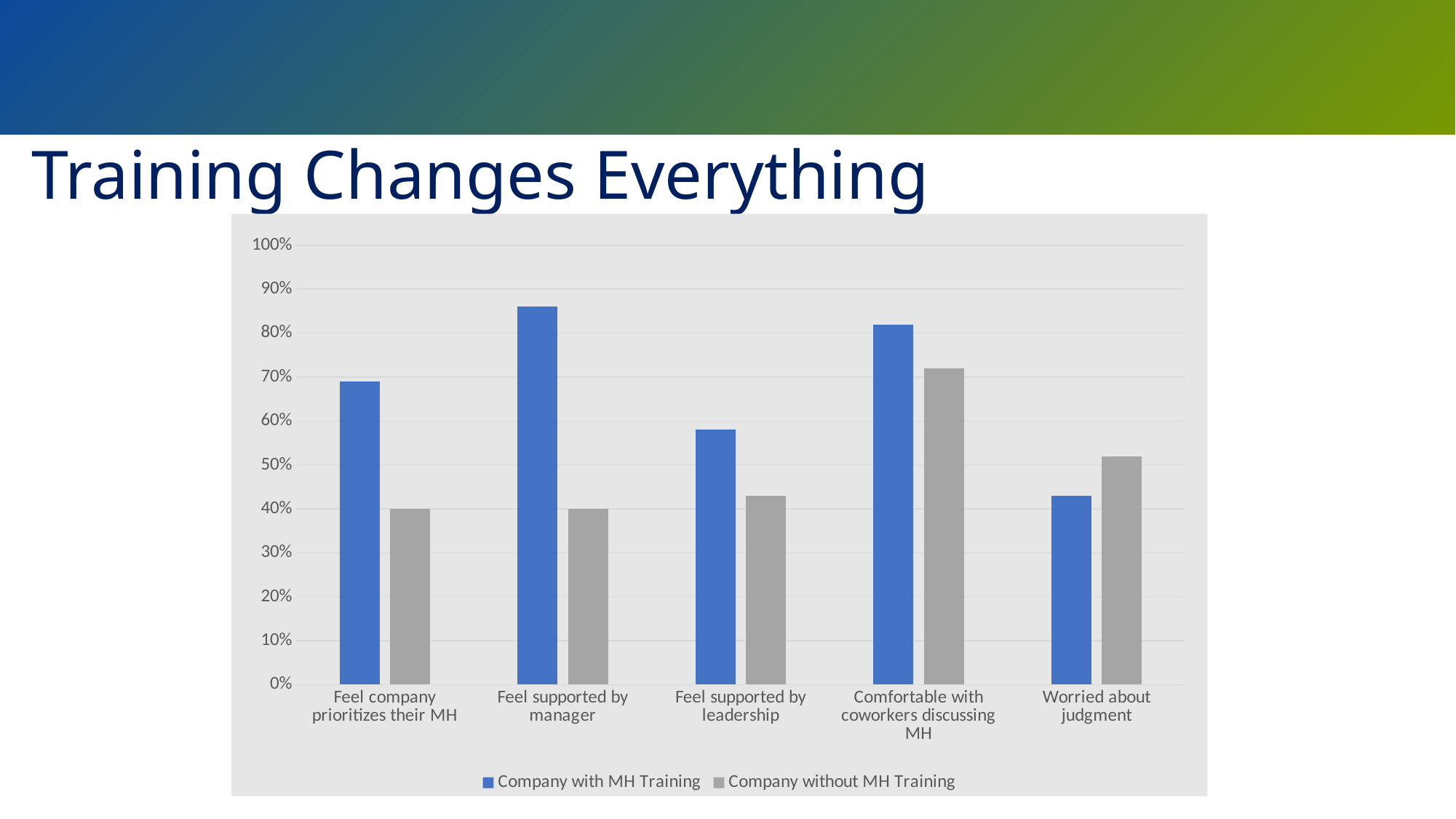
How many series does the chart's legend list? 2 Is the value for Company without MH Training in the 'Worried about judgment' category greater or less than 50%? greater Is the value for Company with MH Training in the 'Feel supported by manager' category greater or less than 80%? greater How many categories are shown along the x axis of the chart? 5 Which category has the lowest value for Company with MH Training? Worried about judgment For the 'Feel company prioritizes their MH' category, which series has the larger value: Company with MH Training or Company without MH Training? Company with MH Training Which category has the highest value for Company without MH Training? Comfortable with coworkers discussing MH Is the value for Company with MH Training in the 'Feel supported by leadership' category greater or less than 60%? less What kind of chart is shown on the slide? bar chart What colour are the bars for the Company with MH Training series? blue For the 'Worried about judgment' category, which series has the larger value: Company with MH Training or Company without MH Training? Company without MH Training Which category has the highest value for Company with MH Training? Feel supported by manager